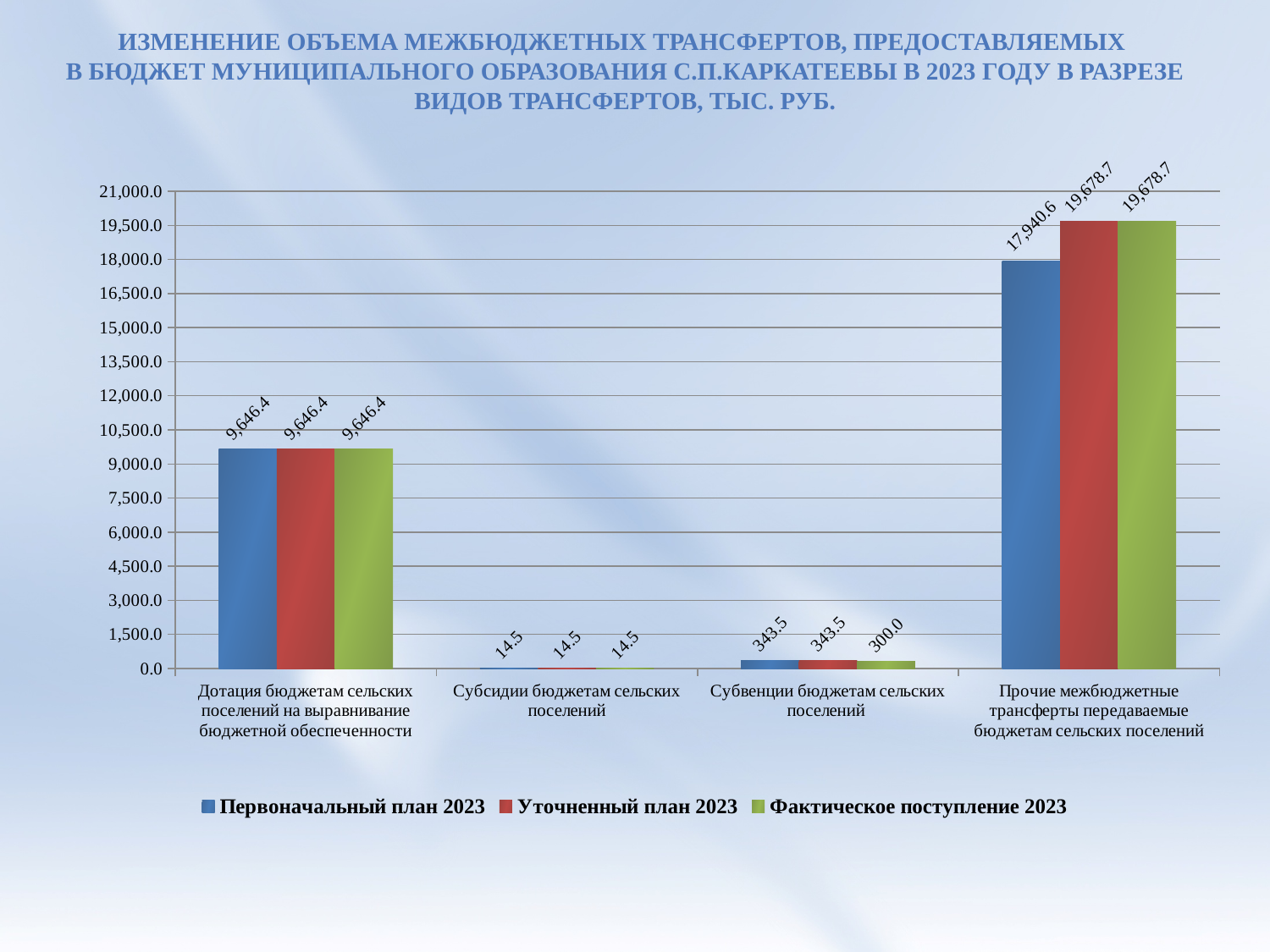
For Субвенции бюджетам сельских поселений, which is larger: Уточненный план 2023 or Фактическое поступление 2023? Уточненный план 2023 What is the difference between Уточненный план 2023 and Фактическое поступление 2023 for Субвенции бюджетам сельских поселений? 43.5 What is the value of Уточненный план 2023 for Дотация бюджетам сельских поселений на выравнивание бюджетной обеспеченности? 9,646.4 How many categories are shown on the x axis? 4 What is the value of Первоначальный план 2023 for Субсидии бюджетам сельских поселений? 14.5 Which category has the lowest value for Уточненный план 2023? Субсидии бюджетам сельских поселений What is the difference between Уточненный план 2023 and Первоначальный план 2023 for Прочие межбюджетные трансферты передаваемые бюджетам сельских поселений? 1,738.1 What is the value of Фактическое поступление 2023 for Субвенции бюджетам сельских поселений? 300.0 What is the value of Первоначальный план 2023 for Прочие межбюджетные трансферты передаваемые бюджетам сельских поселений? 17,940.6 Which category has the highest value for Фактическое поступление 2023? Прочие межбюджетные трансферты передаваемые бюджетам сельских поселений What kind of chart is shown on the slide? Bar chart How many series does the legend list? 3